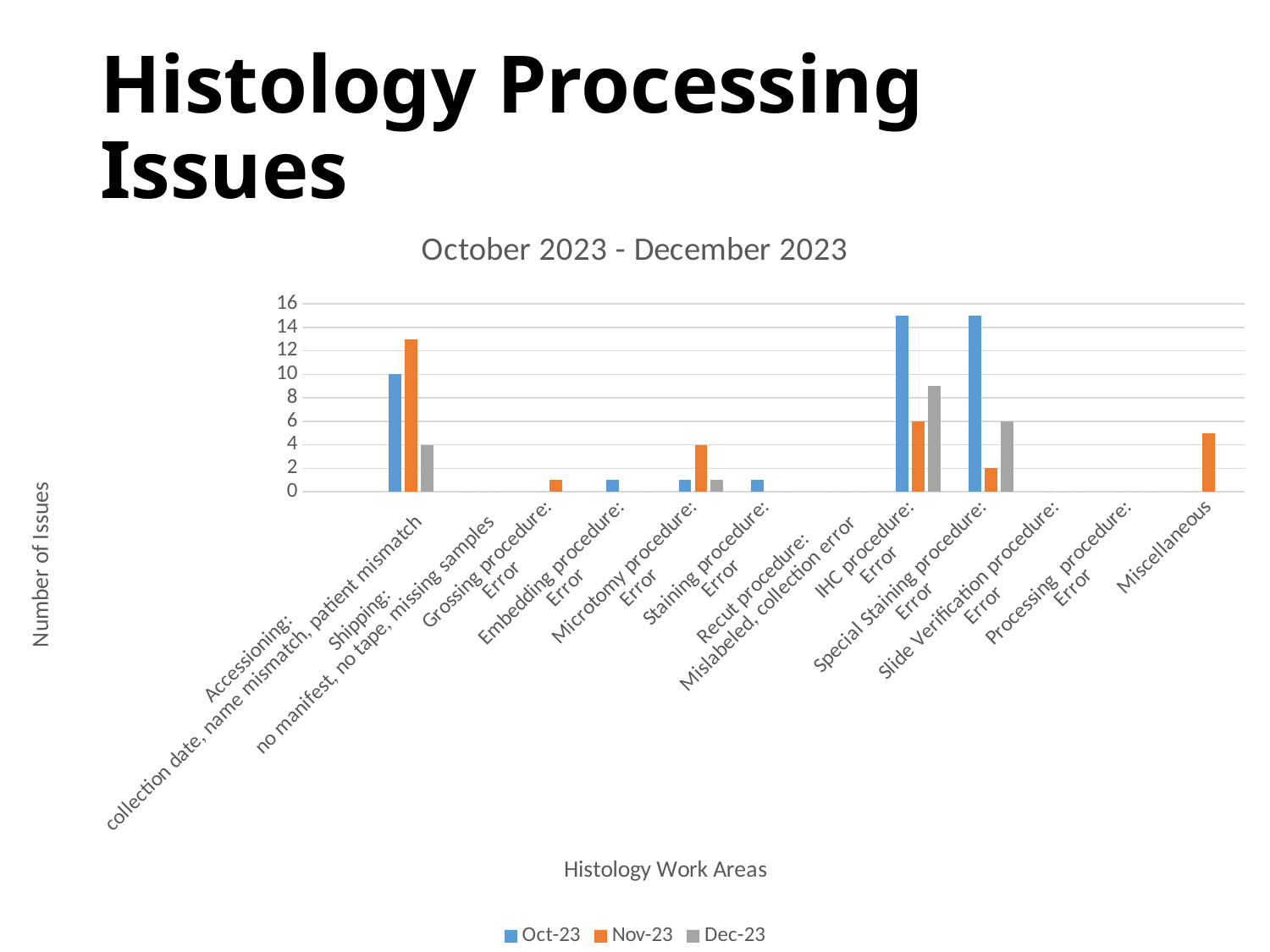
What is the Nov-23 value for IHC procedure: Error? 6 Is the Nov-23 value for Accessioning greater or less than 12? greater What is the difference between the Oct-23 and Dec-23 values for Accessioning? 6 What is the Oct-23 value for Accessioning? 10 Is the Oct-23 value for IHC procedure: Error greater or less than 14? greater For Accessioning, which is larger: the Oct-23 value or the Nov-23 value? Nov-23 What is the Nov-23 value for Microtomy procedure: Error? 4 What is the Dec-23 value for Accessioning? 4 Which category has the highest Nov-23 value? Accessioning Which category has the highest Dec-23 value? IHC procedure: Error What is the Dec-23 value for Special Staining procedure: Error? 6 How many series does the legend list? 3